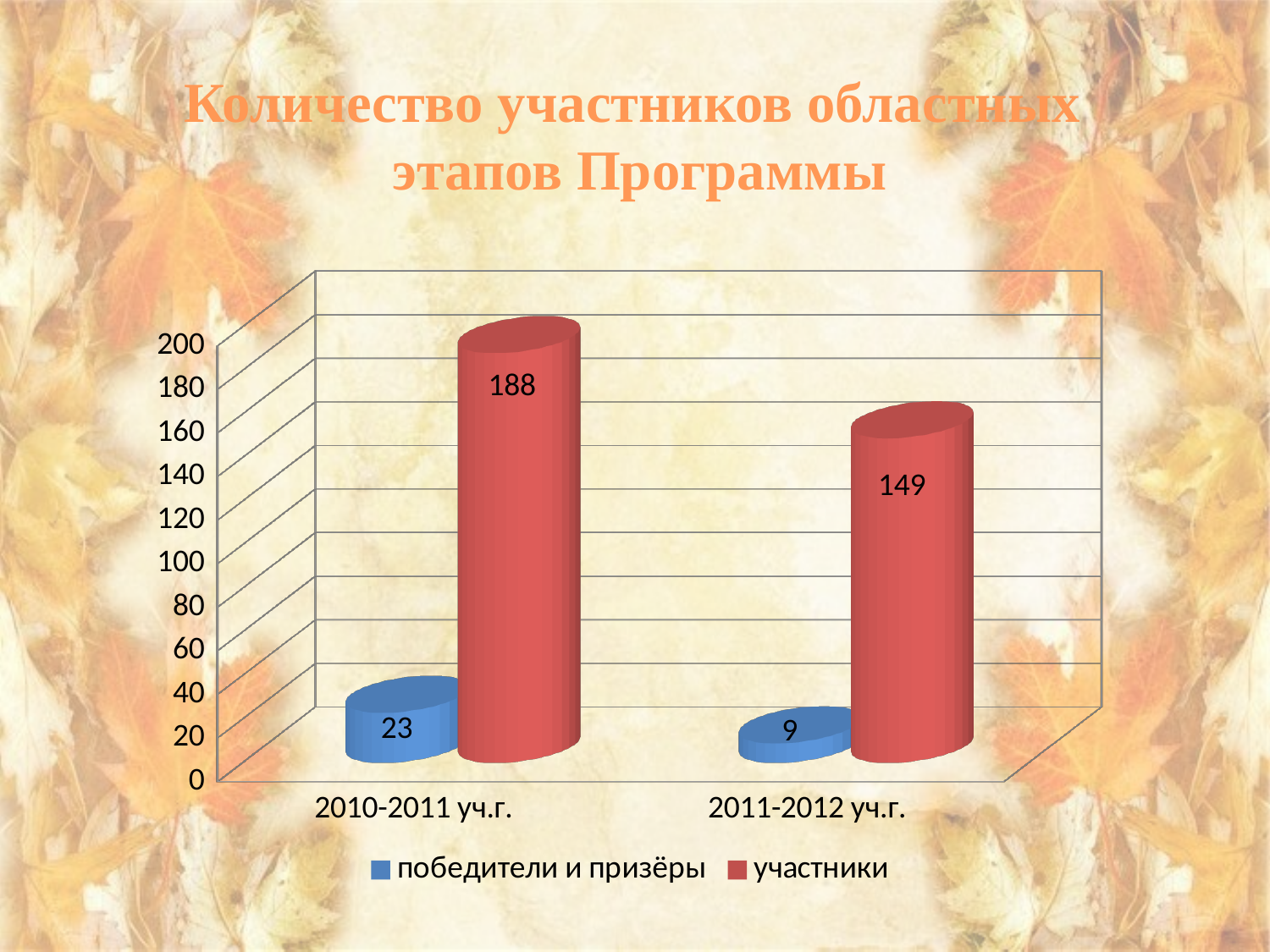
What is the difference between участники in 2010-2011 уч.г. and 2011-2012 уч.г.? 39 What is the value for участники in 2010-2011 уч.г.? 188 Which year has the highest value for участники? 2010-2011 уч.г. How many categories are shown on the x axis? 2 Which is larger: участники in 2010-2011 уч.г. or участники in 2011-2012 уч.г.? 2010-2011 уч.г. What kind of chart is shown on the slide? bar chart Which year has the lowest value for победители и призёры? 2011-2012 уч.г. What is the difference between победители и призёры in 2010-2011 уч.г. and 2011-2012 уч.г.? 14 What is the value for участники in 2011-2012 уч.г.? 149 What is the value for победители и призёры in 2011-2012 уч.г.? 9 How many series does the legend list? 2 What is the value for победители и призёры in 2010-2011 уч.г.? 23